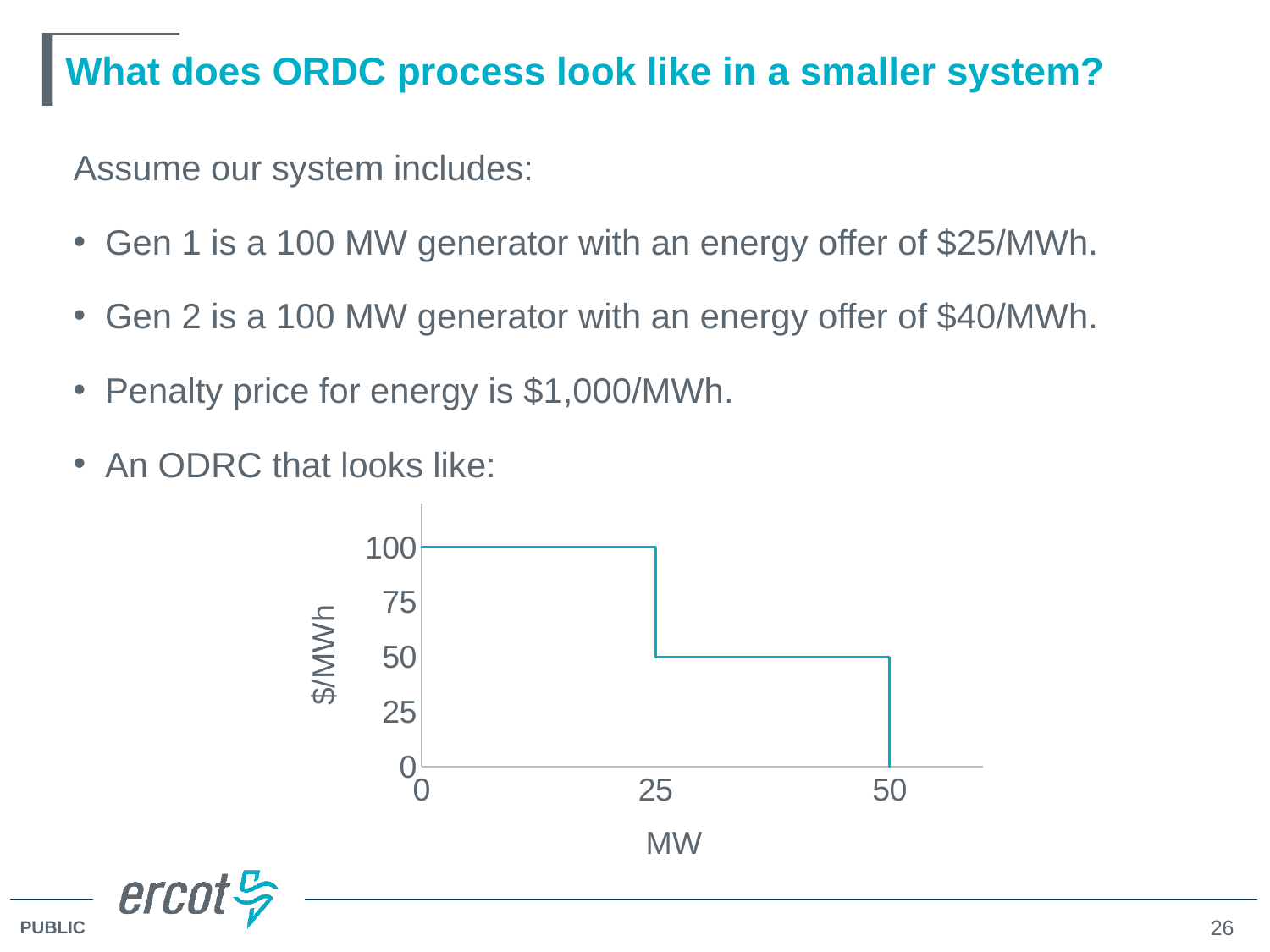
At what MW value does the curve drop to 0 $/MWh? 50 At what MW value does the curve first step down from 100 $/MWh? 25 What is the label of the y axis of the chart? $/MWh What is the $/MWh value of the curve between 0 and 25 MW? 100 What is the highest $/MWh value reached by the curve? 100 Is the $/MWh value at 40 MW greater or less than 75? less Which is larger: the $/MWh value at 10 MW or the $/MWh value at 40 MW? 10 MW Do the $/MWh values rise or fall as MW increases along the x axis? fall What is the difference in $/MWh between the first step (0 to 25 MW) and the second step (25 to 50 MW)? 50 What is the label of the x axis of the chart? MW What kind of chart is shown on the slide? line chart What is the $/MWh value of the curve between 25 and 50 MW? 50